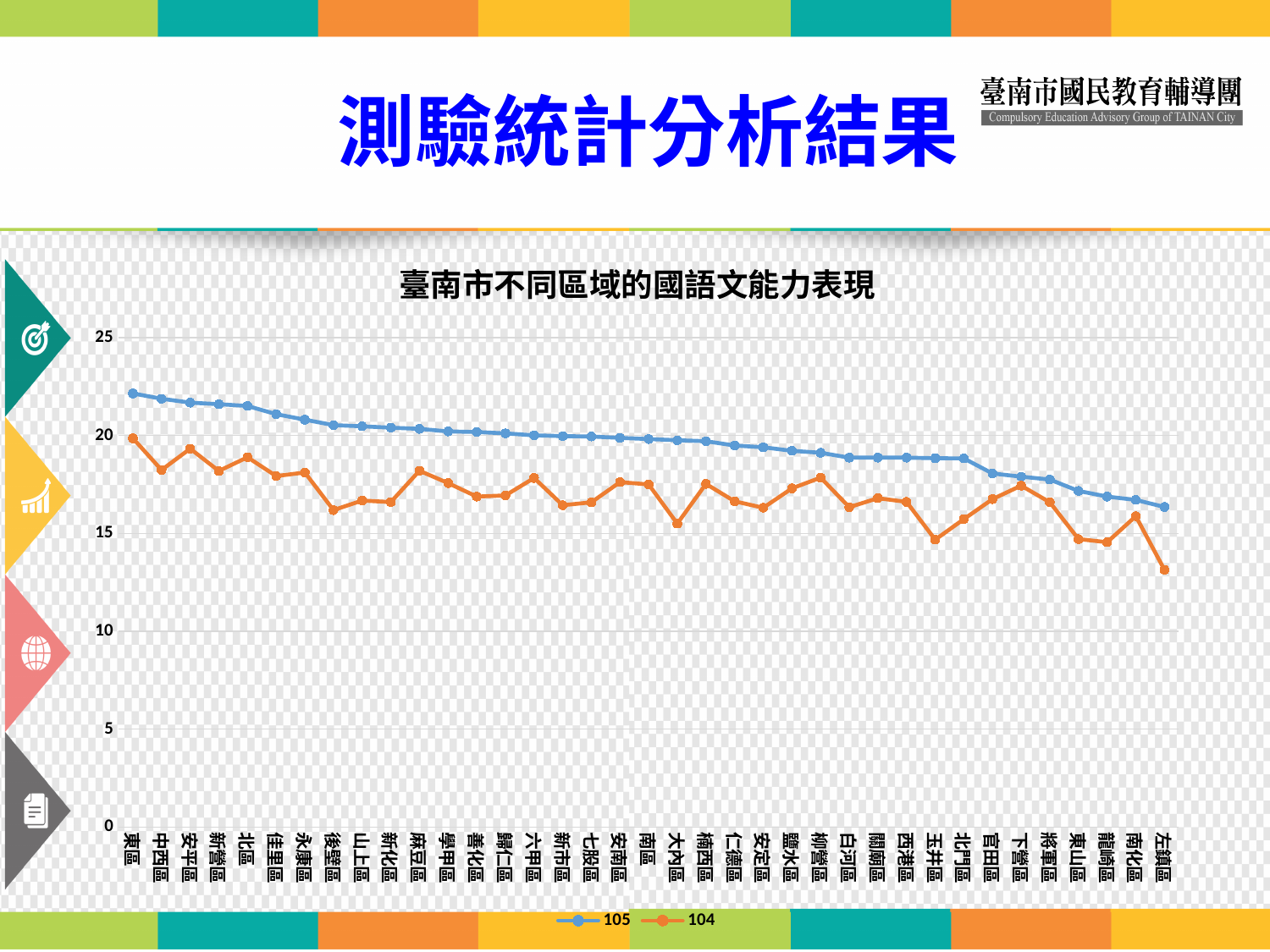
For 東區, which series has the larger value, 105 or 104? 105 Is the 105 value for 東區 greater or less than 20? greater Which district has the lowest value in the 104 series? 左鎮區 Which district has the lowest value in the 105 series? 左鎮區 Do the values of the 105 series rise or fall moving from left to right along the x axis? fall Is the 104 value for 左鎮區 greater or less than 15? less How many series does the legend list? 2 How many districts are shown on the x axis? 37 What is the title of the chart? 臺南市不同區域的國語文能力表現 Which district has the highest value in the 105 series? 東區 What are the two series named in the legend? 105 and 104 What kind of chart is shown on the slide? line chart